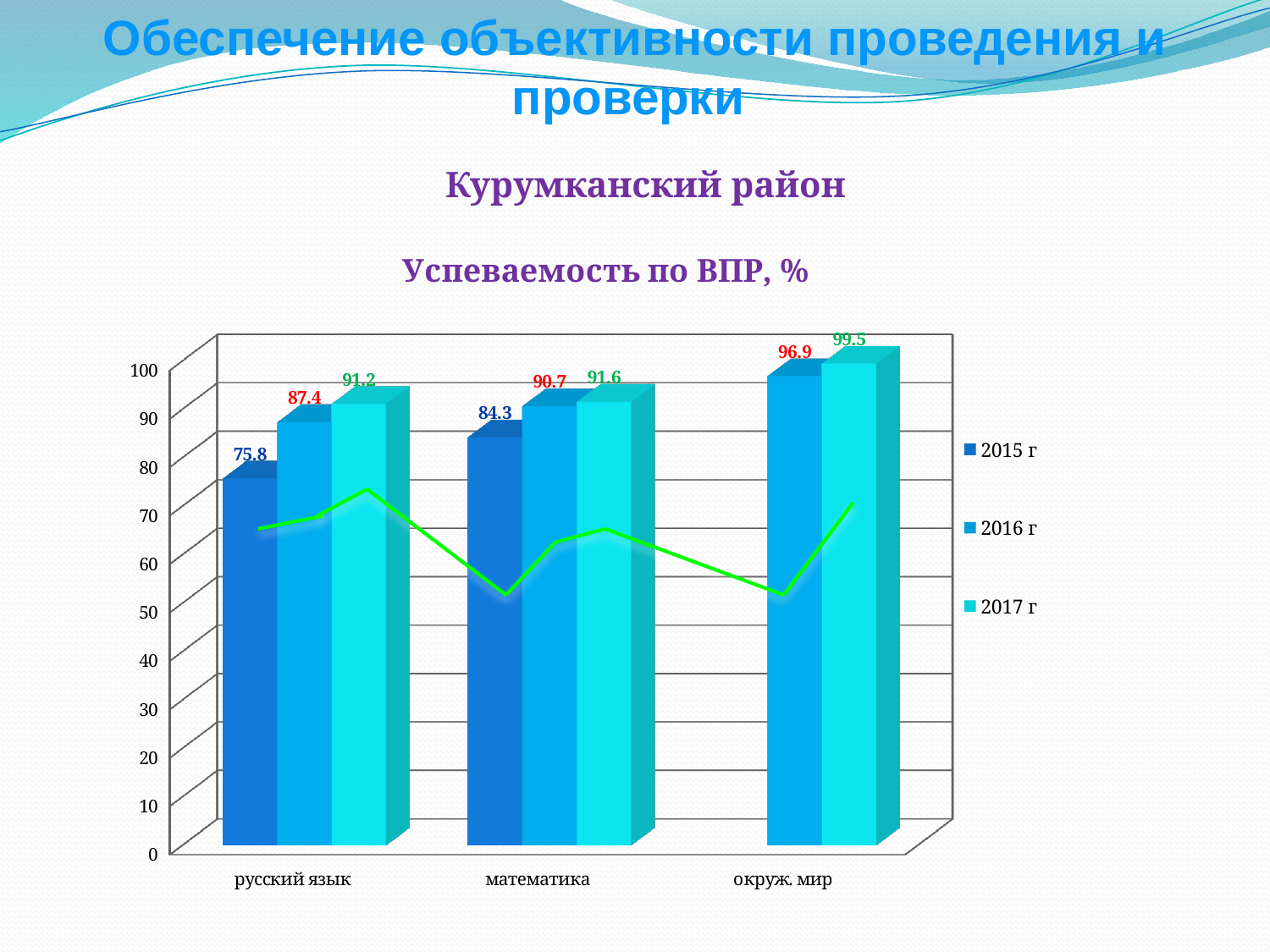
In the 2016 г series, which is larger: русский язык or математика? математика What kind of chart is shown on the slide? bar chart What is the difference between the 2016 г and 2015 г values for математика? 6.4 Which category has the highest value in the 2017 г series? окруж. мир What is the title of the chart? Успеваемость по ВПР, % What is the value for окруж. мир in the 2016 г series? 96.9 Which category has the lowest value in the 2015 г series? русский язык What is the value for математика in the 2017 г series? 91.6 What is the difference between the 2017 г and 2015 г values for русский язык? 15.4 What is the value for русский язык in the 2015 г series? 75.8 How many categories are shown on the x axis? 3 How many series does the legend list? 3